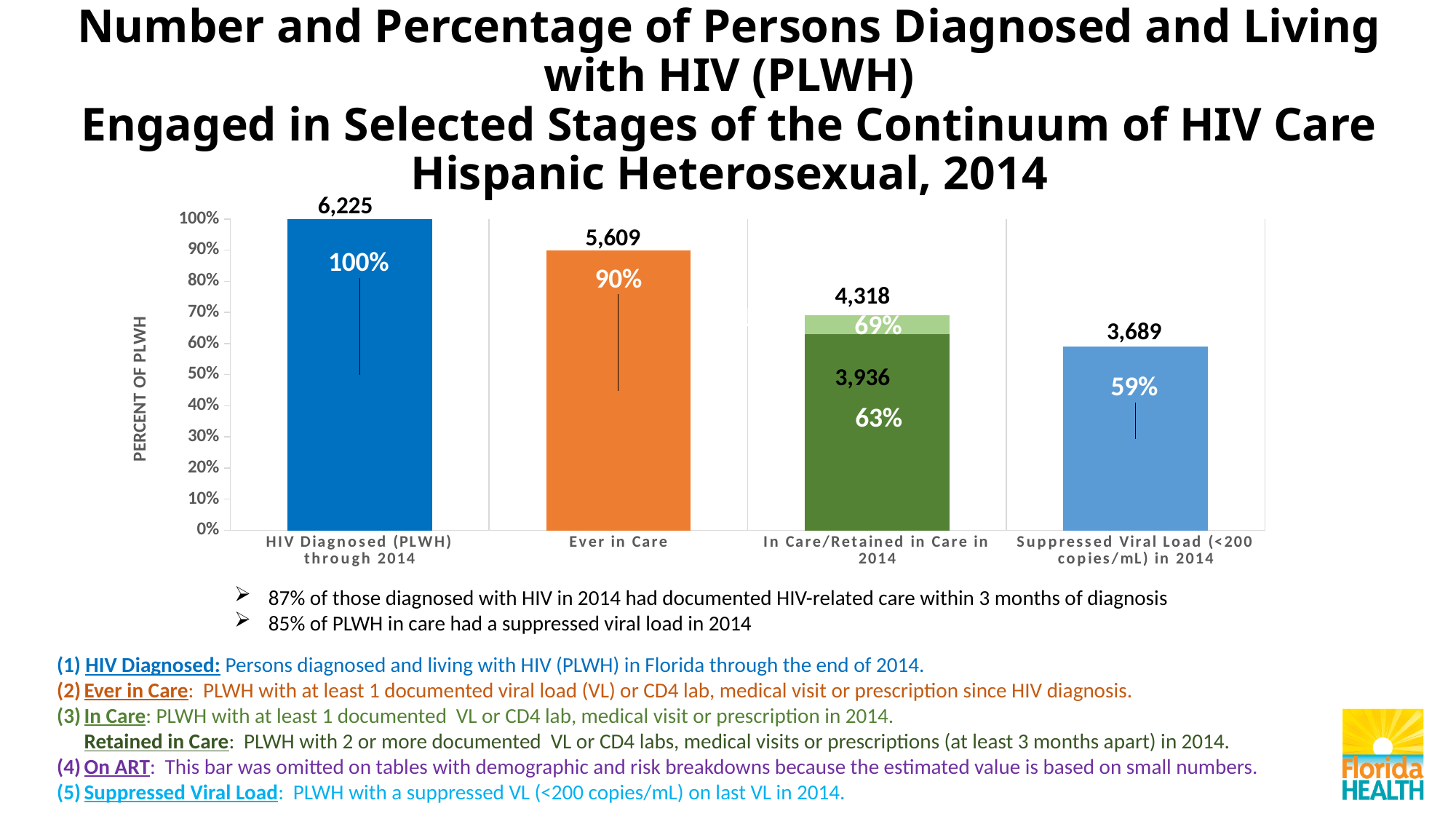
What number is shown for the retained-in-care (dark green) portion of the 'In Care/Retained in Care in 2014' bar? 3,936 What is the number of persons labeled at the top of the 'In Care/Retained in Care in 2014' bar? 4,318 What is the difference in number of persons between 'HIV Diagnosed (PLWH) through 2014' and 'Ever in Care'? 616 Which category has the lowest number of persons? Suppressed Viral Load (<200 copies/mL) in 2014 Which is larger: the number for 'Ever in Care' or the number for 'Suppressed Viral Load (<200 copies/mL) in 2014'? Ever in Care How many categories are shown on the x axis of the chart? 4 What is the number of persons shown for the 'Ever in Care' bar? 5,609 What percentage of PLWH is shown for 'Suppressed Viral Load (<200 copies/mL) in 2014'? 59% What kind of chart is shown on the slide? Bar chart What percentage is shown for the retained-in-care (dark green) portion of the 'In Care/Retained in Care in 2014' bar? 63% Which category has the highest number of persons? HIV Diagnosed (PLWH) through 2014 Do the bar values rise or fall from left to right across the chart? Fall